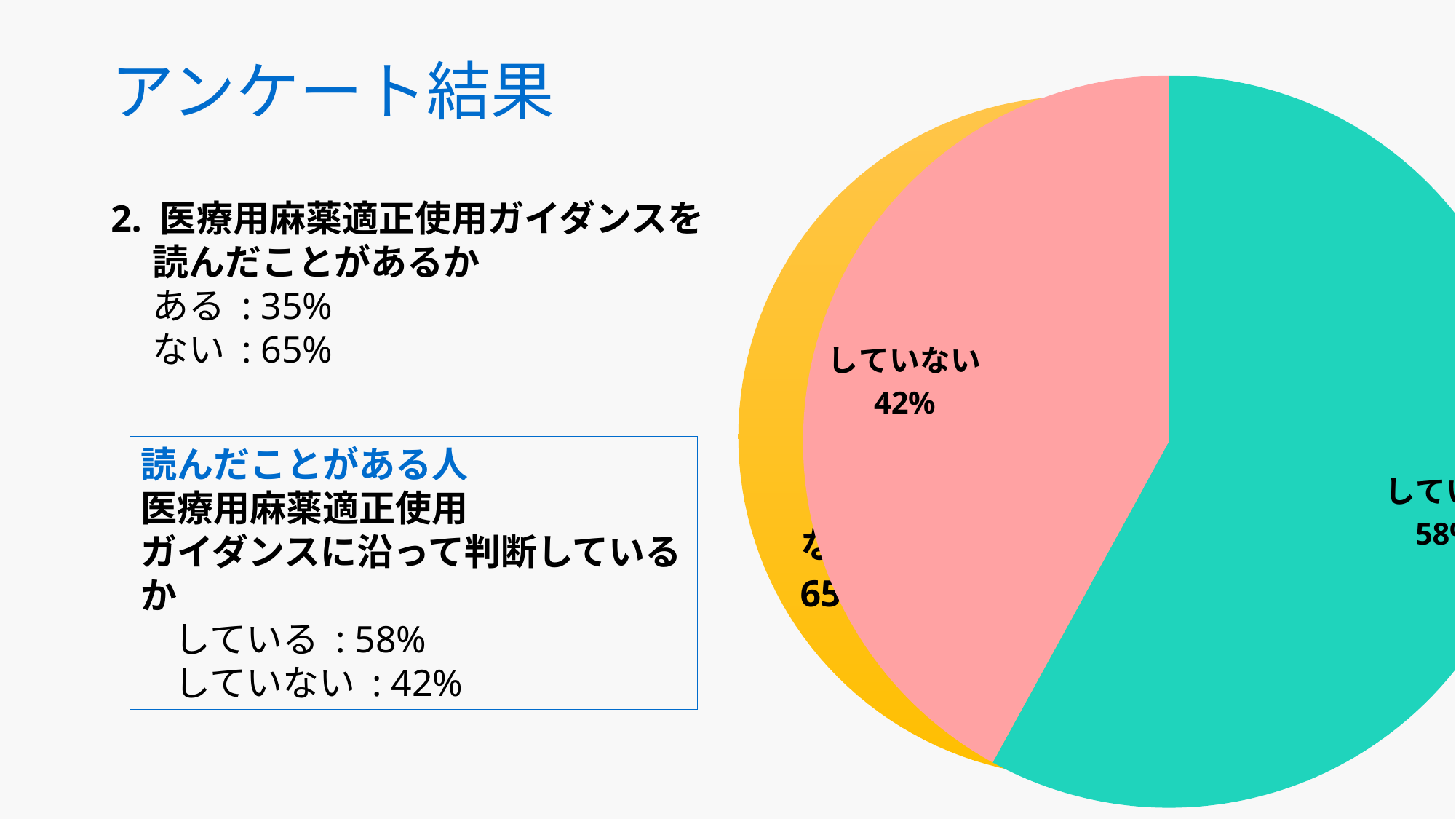
In the front pie chart, what is the difference in percentage points between している and していない? 16 What kind of chart is shown on the right of the slide? pie chart In the front pie chart, what percentage is shown for している? 58% What colour is the していない slice in the front pie chart? pink How many slices does the front pie chart have? 2 In the front pie chart, what share of the pie does the していない slice represent? 42% In the front pie chart, which slice is the largest? している In the front pie chart, which is larger, している or していない? している In the front pie chart, which slice is the smallest? していない In the front pie chart, what percentage is shown for していない? 42% What colour is the している slice in the front pie chart? teal In the front pie chart, is the value for している greater or less than 50%? greater